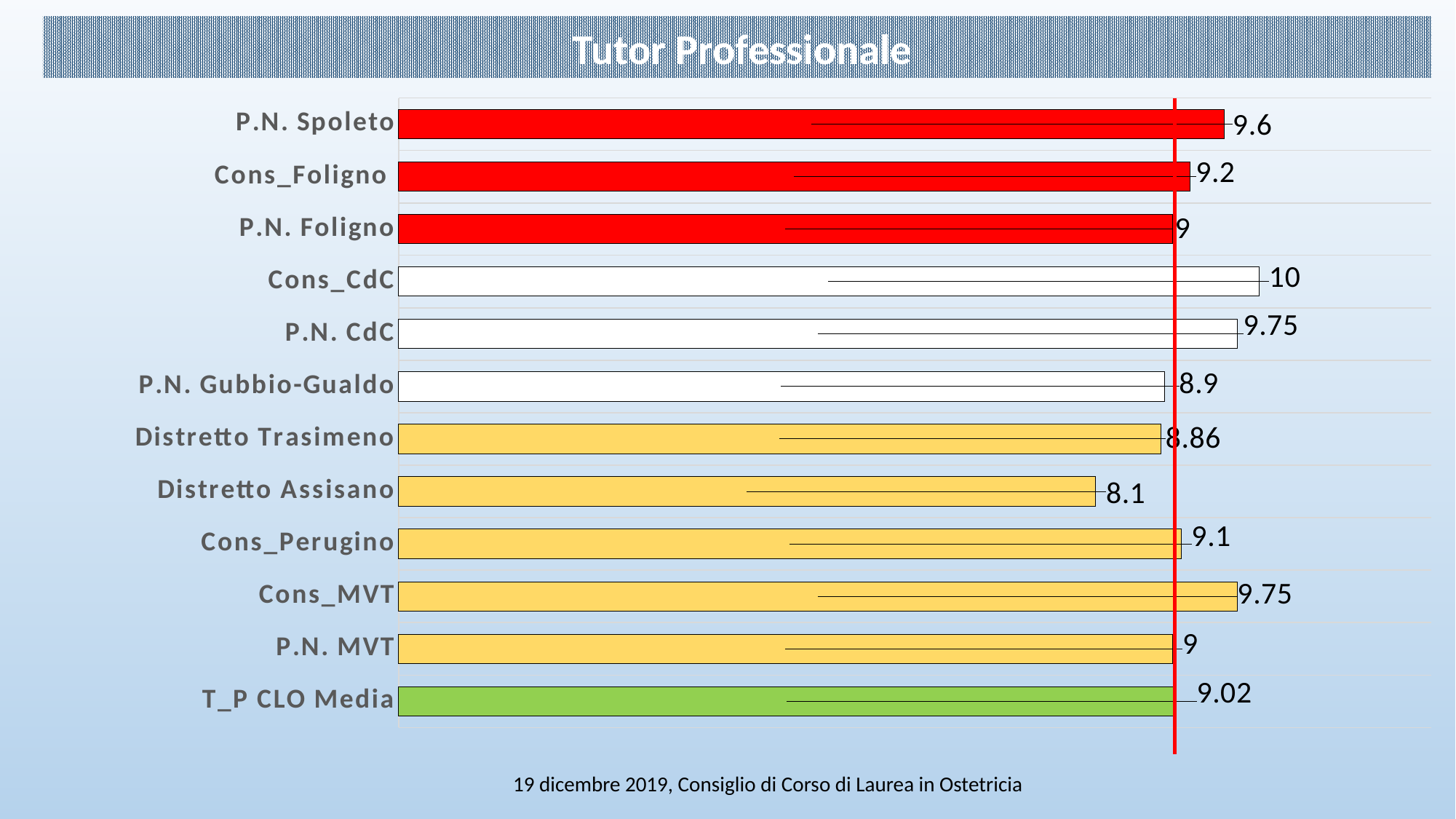
What is the difference between the values for P.N. Spoleto and Cons_Foligno? 0.4 What kind of chart is shown on the slide? Bar chart What is the value for Cons_MVT? 9.75 What is the value for P.N. Spoleto? 9.6 Which is larger, the value for P.N. Spoleto or the value for Cons_Perugino? P.N. Spoleto What is the value for T_P CLO Media? 9.02 What is the title of the chart? Tutor Professionale What is the value for Distretto Trasimeno? 8.86 What is the difference between the values for Cons_CdC and Distretto Assisano? 1.9 Which category has the highest value? Cons_CdC Which category has the lowest value? Distretto Assisano How many categories are shown in the chart? 12